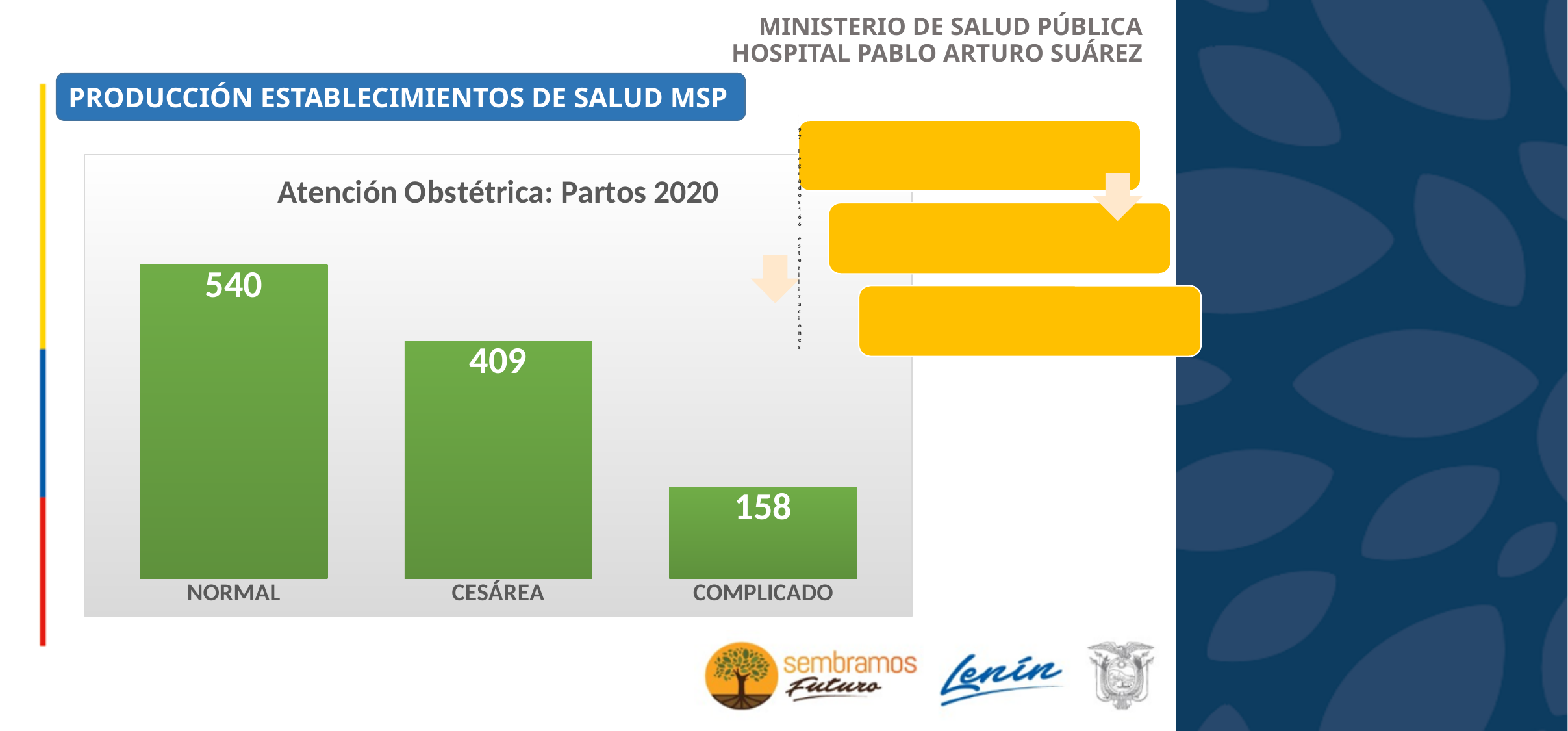
Which category has the highest value? NORMAL Do the values rise or fall from left to right across the categories? Fall How many categories are shown in the chart? 3 Which is larger, the value for CESÁREA or the value for COMPLICADO? CESÁREA What is the value for COMPLICADO in the chart? 158 Which category has the lowest value? COMPLICADO What is the value for CESÁREA in the chart? 409 What kind of chart is shown on the slide? Bar chart What is the title of the chart? Atención Obstétrica: Partos 2020 What is the difference between the values for CESÁREA and COMPLICADO? 251 What is the value for NORMAL in the chart? 540 What is the difference between the values for NORMAL and CESÁREA? 131